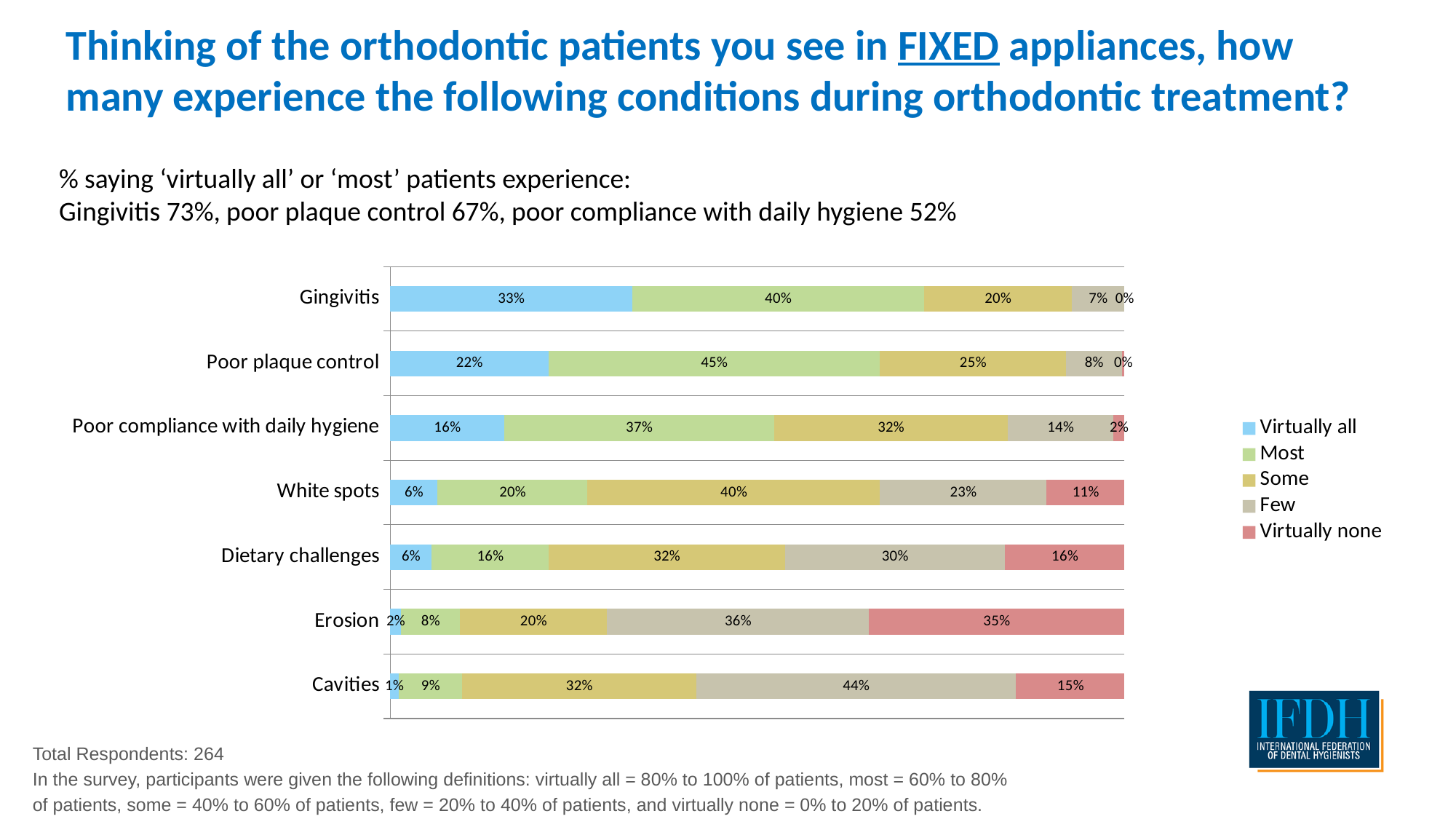
What is the difference between the 'Some' values for White spots and Erosion? 20% What kind of chart is shown on the slide? Stacked bar chart What is the 'Virtually none' value for Erosion? 35% Which condition has the highest 'Virtually all' value? Gingivitis How many series does the legend list? 5 What is the 'Few' value for Cavities? 44% Which condition has the lowest 'Virtually all' value? Cavities Which legend entry is shown in red? Virtually none What is the 'Most' value for Poor plaque control? 45% Which is larger: the 'Virtually none' value for Dietary challenges or for Cavities? Dietary challenges How many conditions are listed on the chart? 7 What percentage of respondents said 'Virtually all' patients experience Gingivitis? 33%